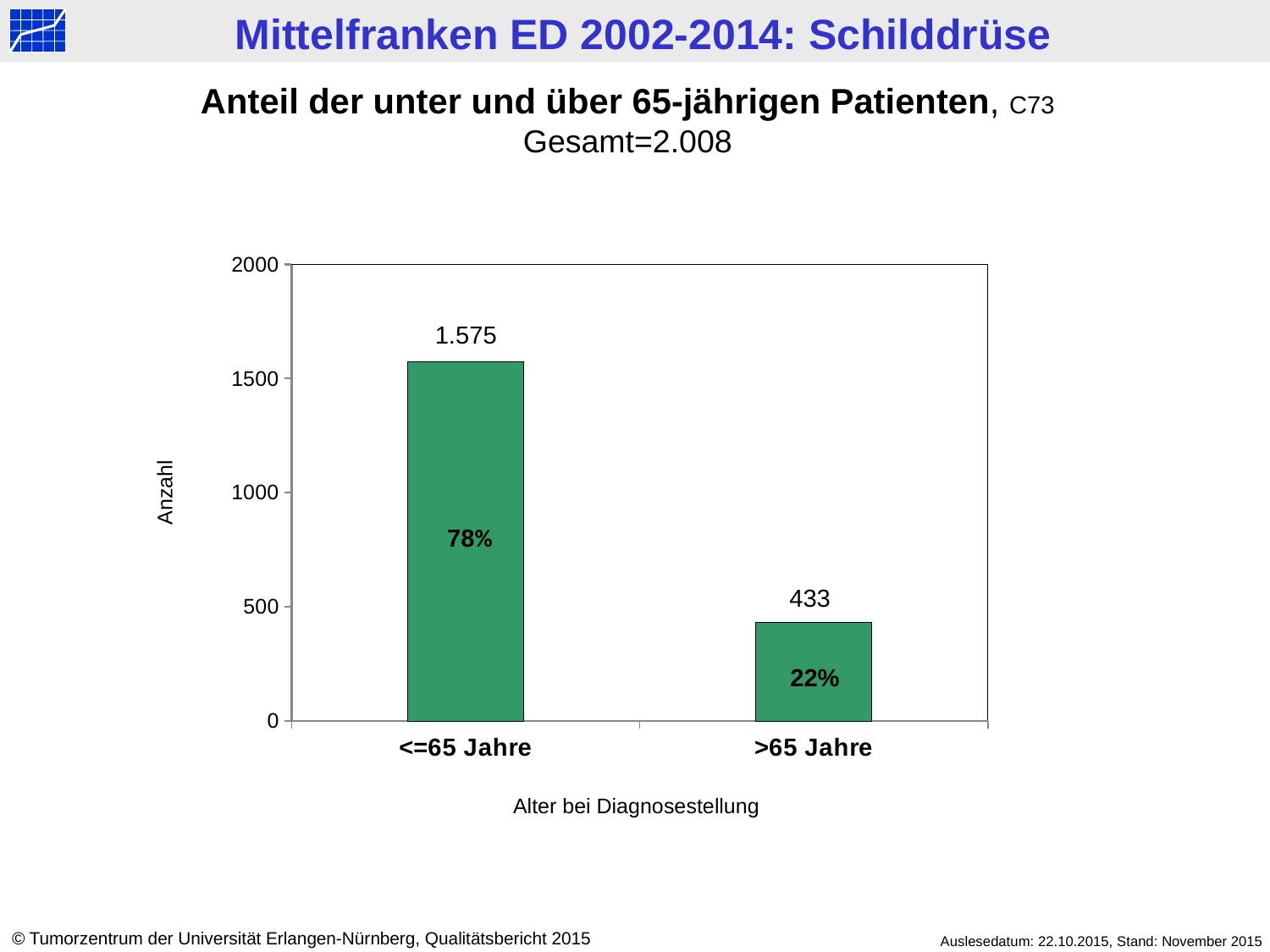
What is the value for the >65 Jahre category? 433 Is the value for >65 Jahre greater or less than 500? less Which is larger, the value for <=65 Jahre or for >65 Jahre? <=65 Jahre How many categories are shown on the x axis? 2 Which category has the highest value? <=65 Jahre What percentage is shown inside the <=65 Jahre bar? 78% What percentage is shown inside the >65 Jahre bar? 22% What kind of chart is shown on the slide? bar chart What is the difference between the values for <=65 Jahre and >65 Jahre? 1.142 What is the label of the y axis? Anzahl What is the value for the <=65 Jahre category? 1.575 Which category has the lowest value? >65 Jahre